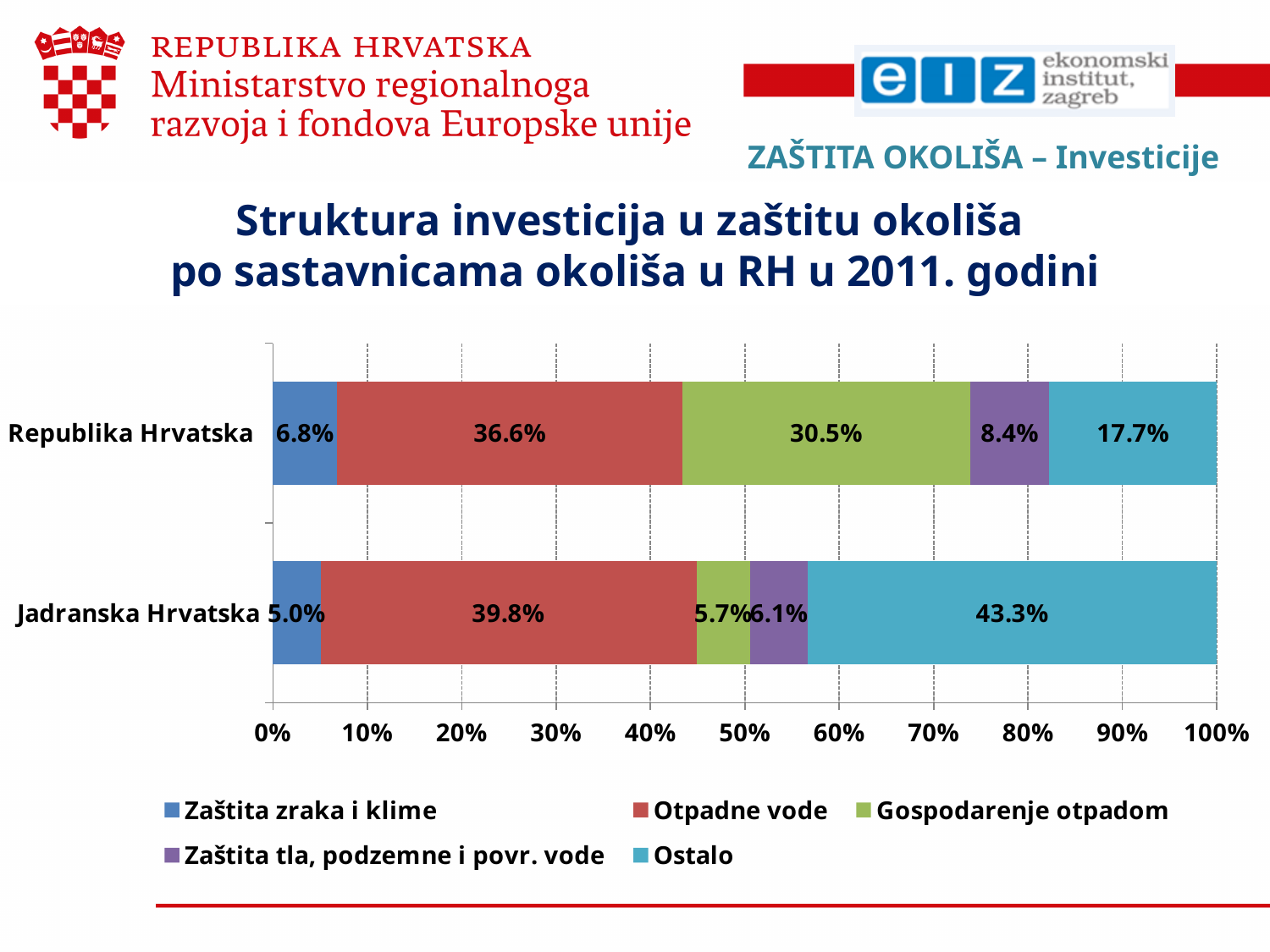
What is the value for Gospodarenje otpadom for Jadranska Hrvatska? 5.7% How many series does the legend list? 5 What is the value for Ostalo for Jadranska Hrvatska? 43.3% What is the value for Otpadne vode for Republika Hrvatska? 36.6% Which is larger: Ostalo for Jadranska Hrvatska or Ostalo for Republika Hrvatska? Jadranska Hrvatska How many categories are shown on the y axis? 2 What is the difference between the Gospodarenje otpadom values for Republika Hrvatska and Jadranska Hrvatska? 24.8% What is the value for Zaštita tla, podzemne i povr. vode for Republika Hrvatska? 8.4% What is the title of the chart? Struktura investicija u zaštitu okoliša po sastavnicama okoliša u RH u 2011. godini Which series has the largest share for Republika Hrvatska? Otpadne vode Which series has the smallest share for Jadranska Hrvatska? Zaštita zraka i klime What kind of chart is shown? Stacked bar chart